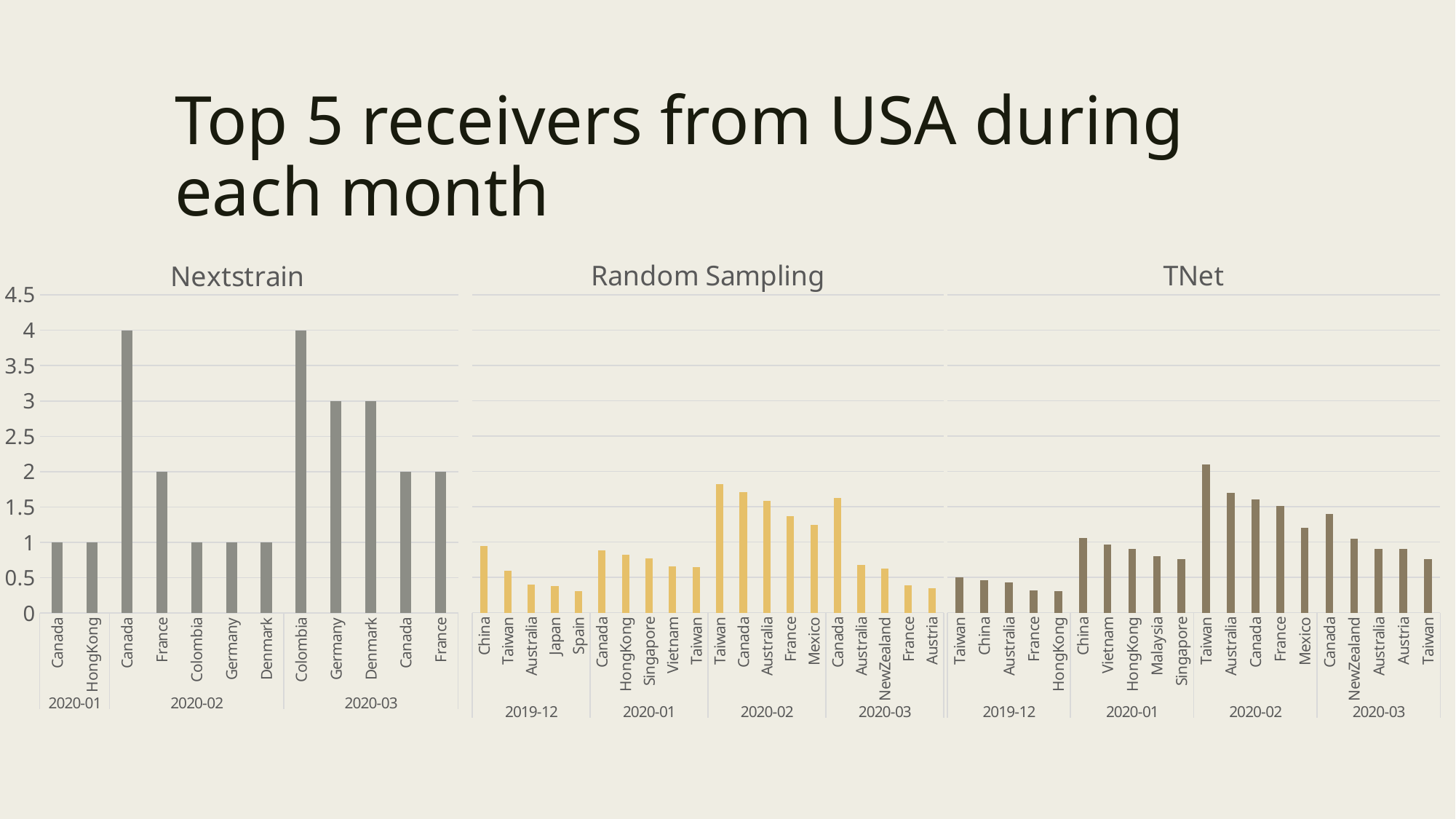
What are the titles of the three charts on the slide? Nextstrain, Random Sampling, TNet In the TNet chart, is the value for Taiwan in 2020-02 greater or less than 2? greater What kind of chart is the Random Sampling chart? bar chart In the Nextstrain chart, which is larger: Denmark in 2020-03 or Denmark in 2020-02? Denmark in 2020-03 In the Nextstrain chart, how many bars are plotted? 12 In the TNet chart, which month group has the highest bar? 2020-02 In the Nextstrain chart, what is the value for France in 2020-02? 2 In the Nextstrain chart, what is the value for Canada in 2020-02? 4 In the Nextstrain chart, what is the difference between Colombia in 2020-03 and Colombia in 2020-02? 3 In the Random Sampling chart, is the value for Taiwan in 2020-02 greater or less than 1.5? greater In the Nextstrain chart, what is the value for Germany in 2020-03? 3 In the Random Sampling chart, is the value for Spain in 2019-12 greater or less than 0.5? less